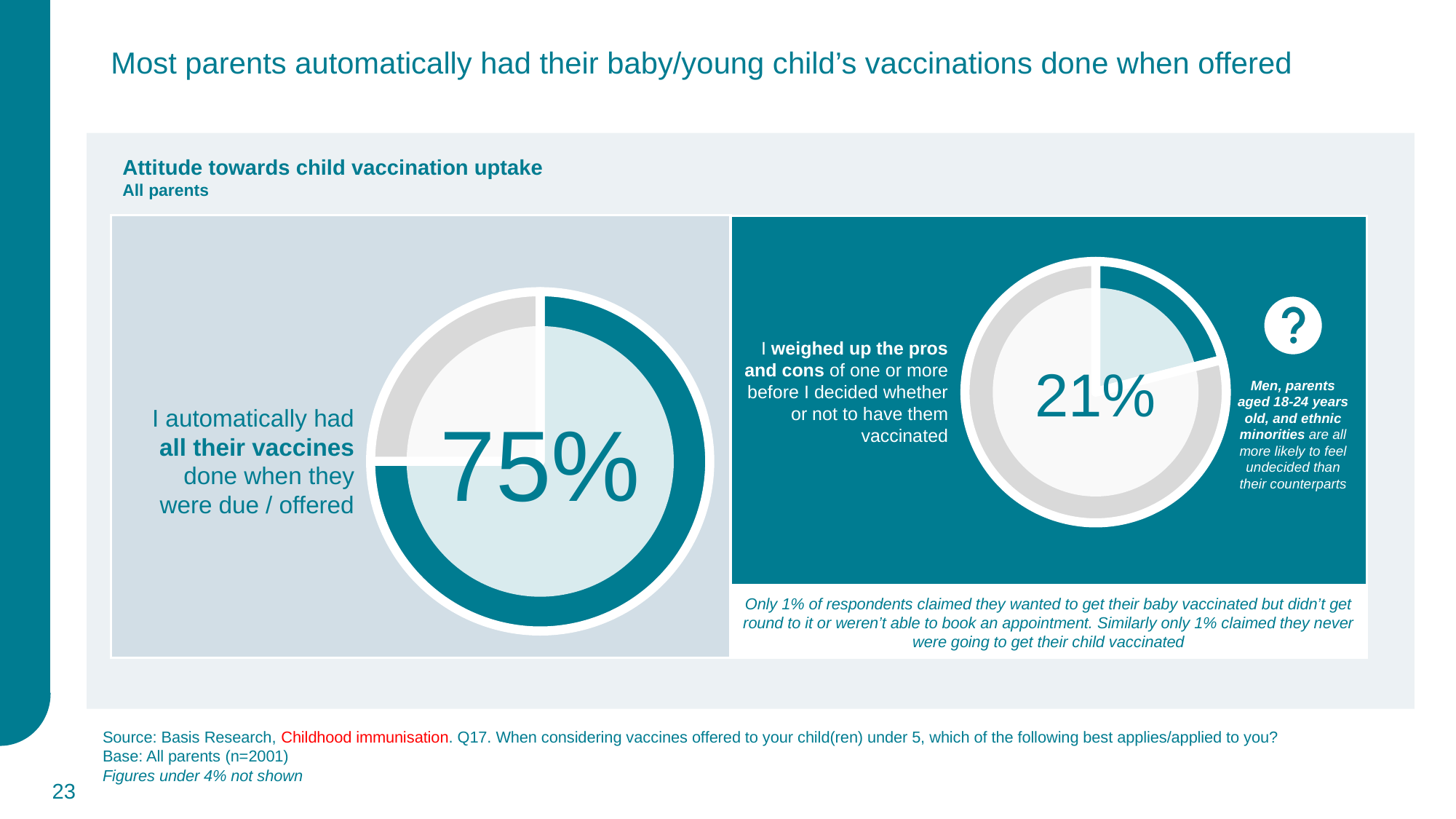
Is the share of parents who weighed up the pros and cons greater or less than 25%? less How many donut charts are shown on the slide? 2 Which attitude has the larger share: automatically having all vaccines done, or weighing up the pros and cons? Automatically having all vaccines done By how many percentage points does the share who automatically had all vaccines done exceed the share who weighed up the pros and cons? 54 percentage points According to the slide, what percentage of respondents claimed they wanted to get their baby vaccinated but didn't get round to it or weren't able to book an appointment? 1% What percentage of parents said they automatically had all their child's vaccines done when they were due / offered? 75% What is the base size (n) for the charts on this slide? n=2001 What percentage of parents said they weighed up the pros and cons of one or more vaccines before deciding whether or not to have them vaccinated? 21% What kind of chart is used to show the 75% and 21% figures on this slide? Donut (ring) chart What is the title of the chart panel on this slide? Attitude towards child vaccination uptake Is the share of parents who automatically had all their child's vaccines done greater or less than 50%? greater